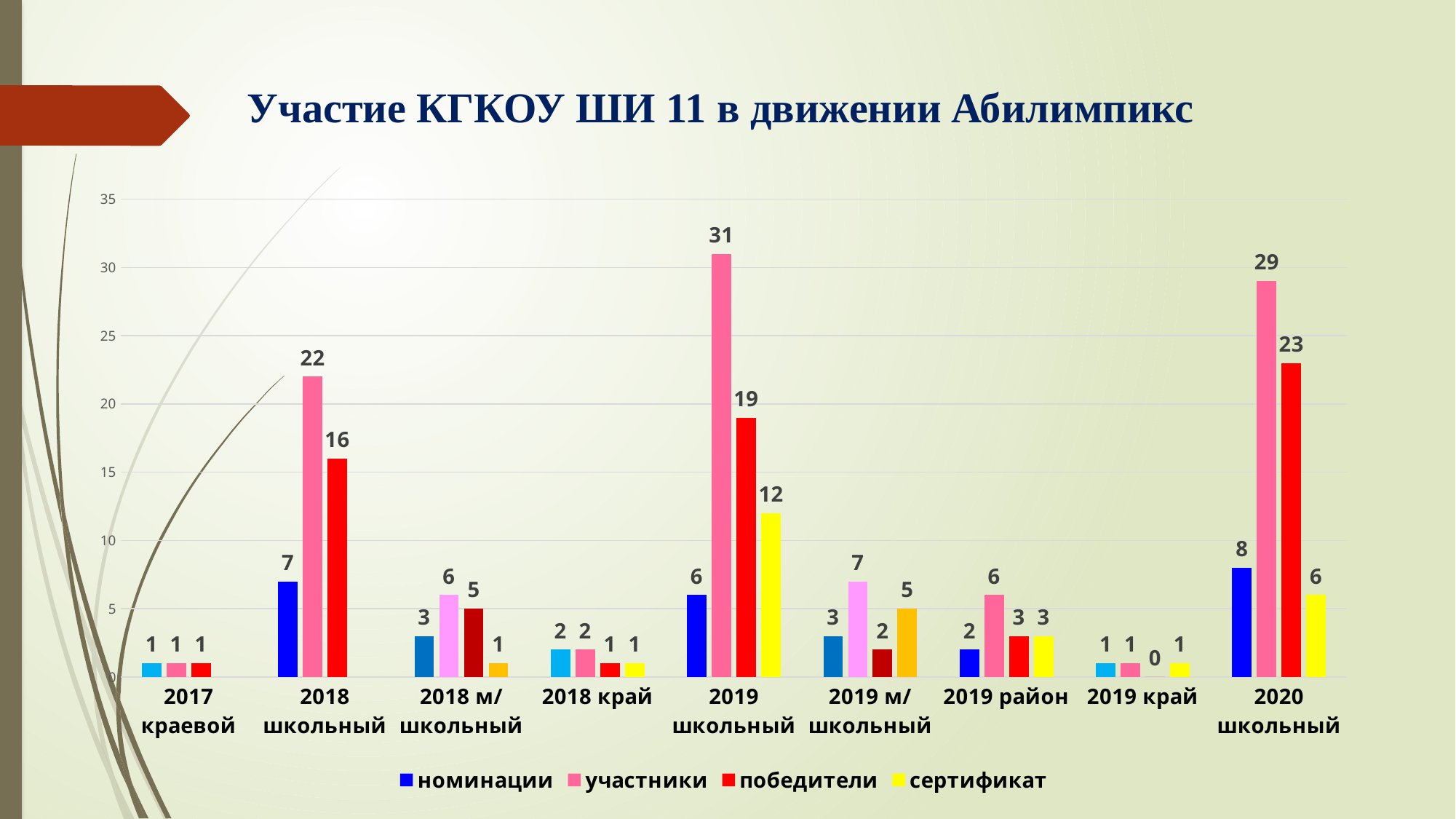
What is the value for победители in 2020 школьный? 23 What is the title of the chart? Участие КГКОУ ШИ 11 в движении Абилимпикс Which category has the highest value for участники? 2019 школьный What is the value for номинации in 2018 школьный? 7 What is the value for участники in 2019 школьный? 31 What is the difference between участники and победители in 2018 школьный? 6 How many categories are shown on the x axis? 9 What is the value for сертификат in 2019 школьный? 12 What kind of chart is shown on the slide? bar chart What is the value for победители in 2019 край? 0 Which is larger: победители in 2019 школьный or победители in 2020 школьный? победители in 2020 школьный How many series does the legend list? 4